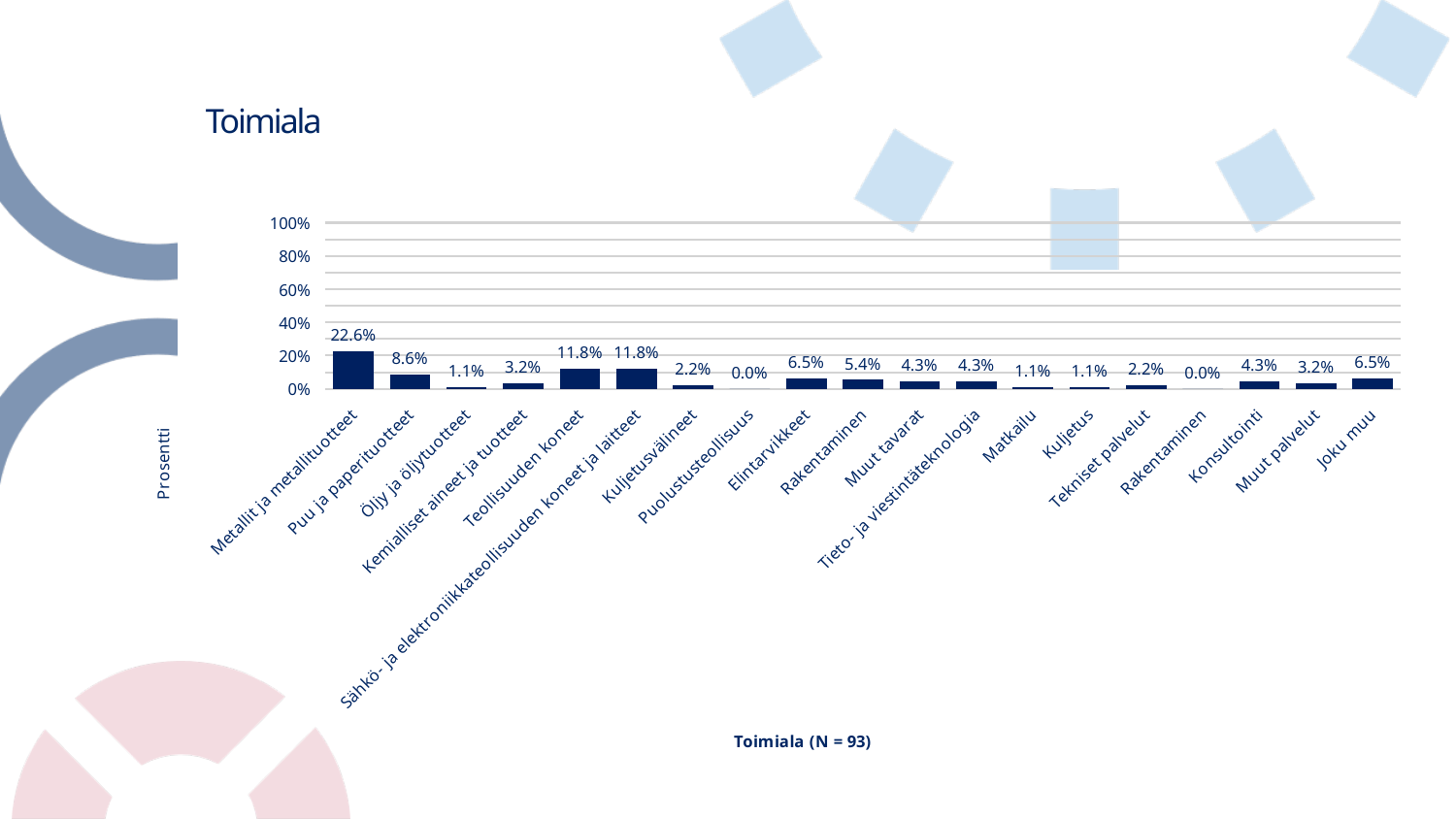
What is the x-axis title of the chart? Toimiala (N = 93) What is the difference between the values for Metallit ja metallituotteet and Puu ja paperituotteet? 14.0% What is the value for Metallit ja metallituotteet? 22.6% What is the value for Elintarvikkeet? 6.5% Which category has the highest value? Metallit ja metallituotteet What is the value for Teollisuuden koneet? 11.8% Which is larger, the value for Joku muu or the value for Muut palvelut? Joku muu Is the value for Metallit ja metallituotteet greater or less than 20%? greater How many categories are shown on the x axis? 19 What kind of chart is shown on the slide? Bar chart What is the value for Konsultointi? 4.3% What is the lowest value shown on the chart? 0.0%